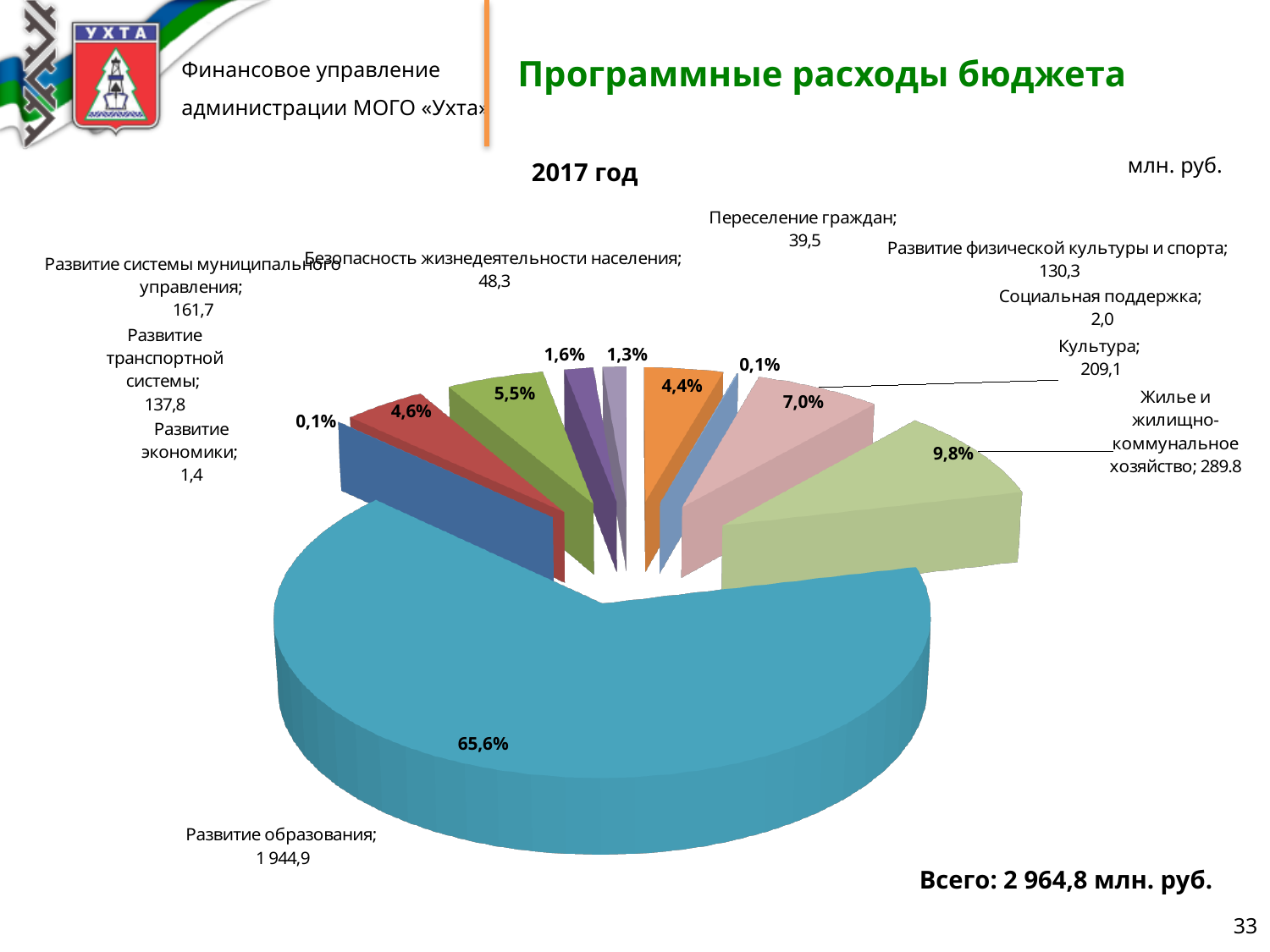
What is the value for Культура? 209,1 Which is larger: the value for Развитие системы муниципального управления or Развитие физической культуры и спорта? Развитие системы муниципального управления Which category has the largest share of the pie? Развитие образования What share of the pie does Развитие образования take? 65,6% What is the value for Развитие транспортной системы? 137,8 What is the difference between the values for Жилье и жилищно-коммунальное хозяйство and Культура? 80,7 What is the value for Развитие образования? 1 944,9 What share of the pie does Жилье и жилищно-коммунальное хозяйство take? 9,8% What total is stated on the slide for the programme expenditures? 2 964,8 млн. руб. How many categories does the pie chart show? 10 What kind of chart is shown on the slide? pie chart What is the value for Переселение граждан? 39,5